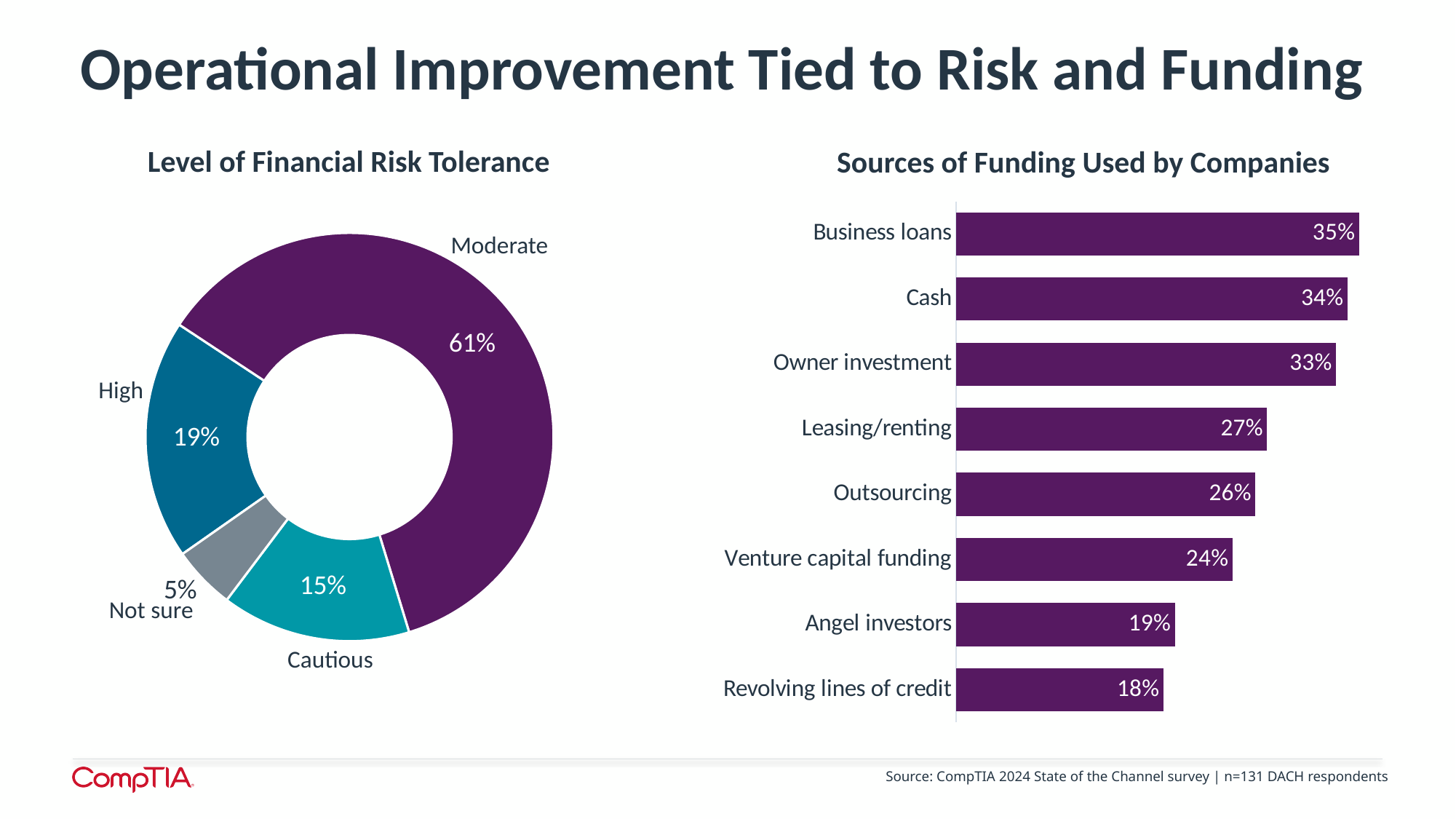
In the 'Sources of Funding Used by Companies' chart, which funding source has the highest value? Business loans In the 'Sources of Funding Used by Companies' chart, which funding source has the lowest value? Revolving lines of credit In the 'Sources of Funding Used by Companies' chart, what percentage of companies use Leasing/renting? 27% In the 'Level of Financial Risk Tolerance' chart, which category has the smallest share? Not sure What type of chart is the 'Level of Financial Risk Tolerance' chart? Doughnut chart In the 'Level of Financial Risk Tolerance' chart, how many categories are shown? 4 In the 'Sources of Funding Used by Companies' chart, what is the difference between Business loans and Angel investors? 16% In the 'Sources of Funding Used by Companies' chart, which is larger: Outsourcing or Venture capital funding? Outsourcing In the 'Level of Financial Risk Tolerance' chart, what is the difference between the High and Cautious shares? 4% In the 'Level of Financial Risk Tolerance' chart, what percentage of respondents reported a Moderate risk tolerance? 61% In the 'Sources of Funding Used by Companies' chart, how many funding sources are listed? 8 What type of chart is the 'Sources of Funding Used by Companies' chart? Bar chart